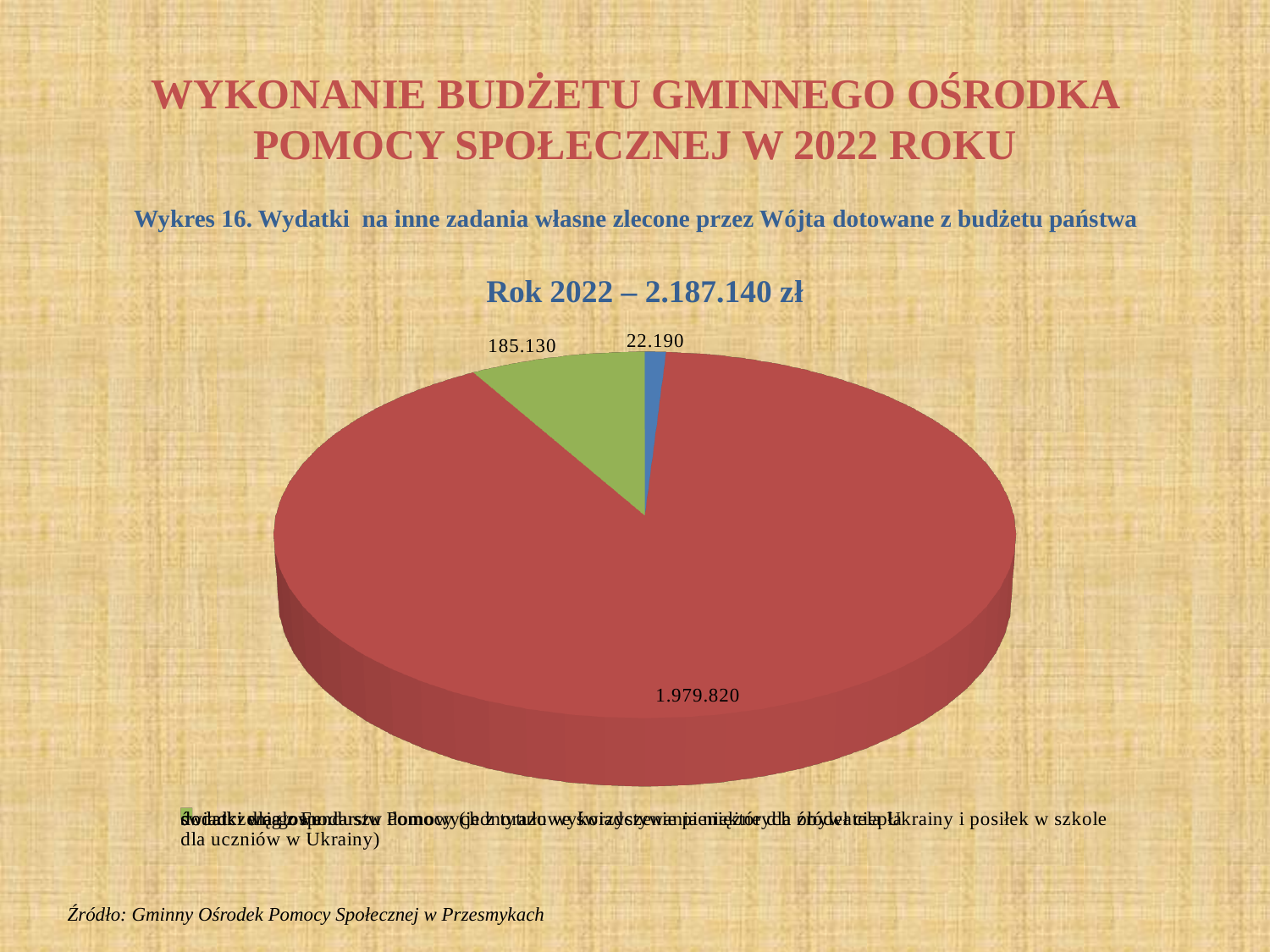
What total amount for 2022 is stated in the chart title above the pie? 2.187.140 zł What is the difference between the green slice (185.130) and the blue slice (22.190)? 162.940 How many slices does the pie chart have? 3 What colour is the largest slice of the pie chart? red What is the value of the largest slice (red) of the pie chart? 1.979.820 What is the difference between the red slice (1.979.820) and the green slice (185.130)? 1.794.690 What kind of chart is shown on the slide? pie chart What is the value of the smallest slice (blue) of the pie chart? 22.190 Which slice is larger, the green one or the blue one? the green one What is the total of all three slices of the pie chart? 2.187.140 What value is labelled on the green slice of the pie chart? 185.130